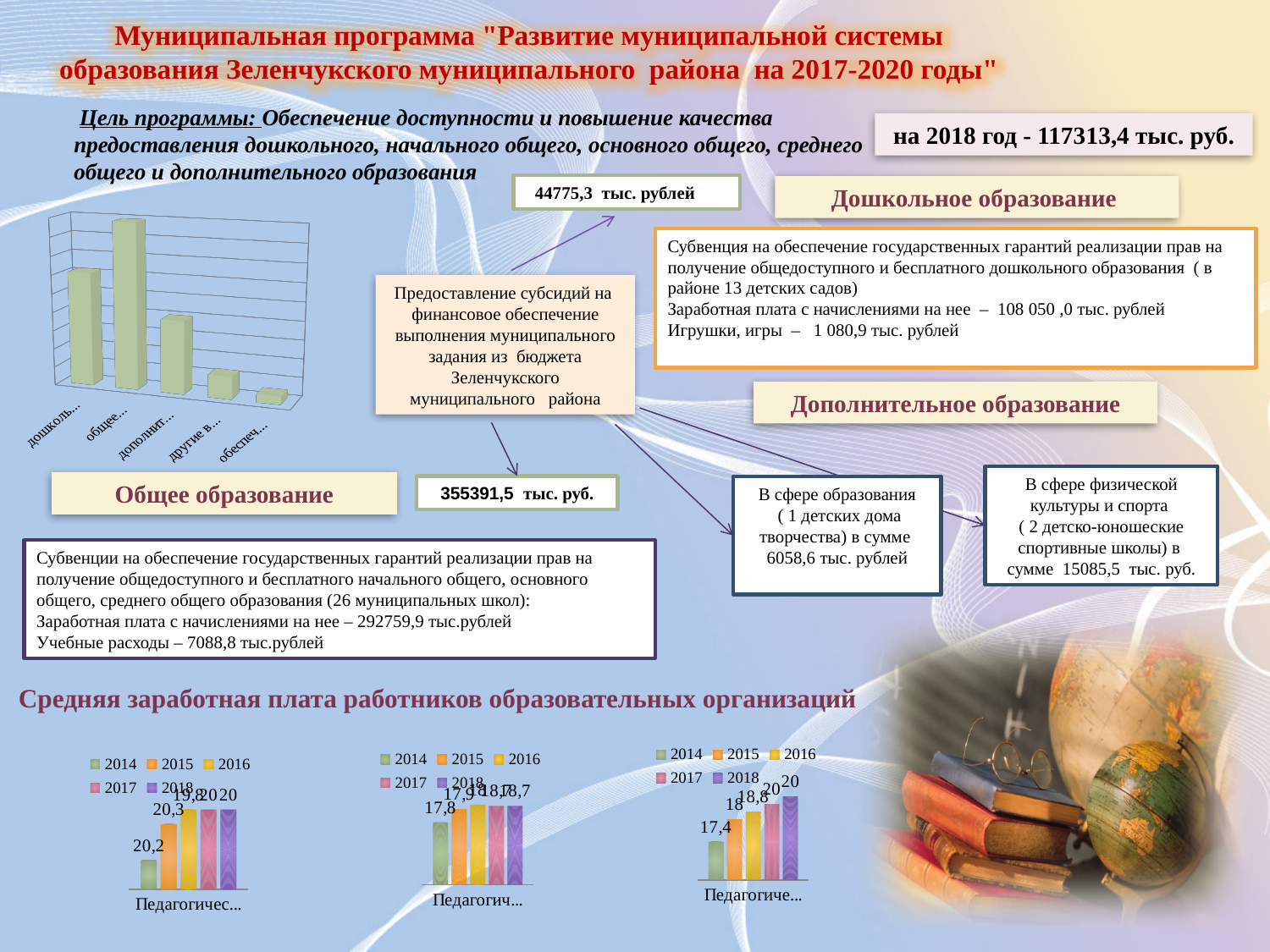
In the bottom-left chart, what is the value for 2014? 20,2 Which years are listed in the legend of the bottom-right chart? 2014, 2015, 2016, 2017, 2018 What kind of chart is the top-left chart on the slide? bar chart In the bottom-right chart, what is the difference between the 2015 value and the 2014 value? 0,6 How many series does the legend of the bottom-left chart list? 5 In the bottom-left chart, what is the value for 2015? 20,3 In the bottom-middle chart, what is the value for 2014? 17,8 In the bottom-right chart, what is the value for 2014? 17,4 How many categories does the top-left chart show? 5 In the top-left chart, which category has the tallest bar? общее... In the top-left chart, which bar is taller: дошколь... or дополнит...? дошколь... In the top-left chart, which category has the shortest bar? обеспеч...